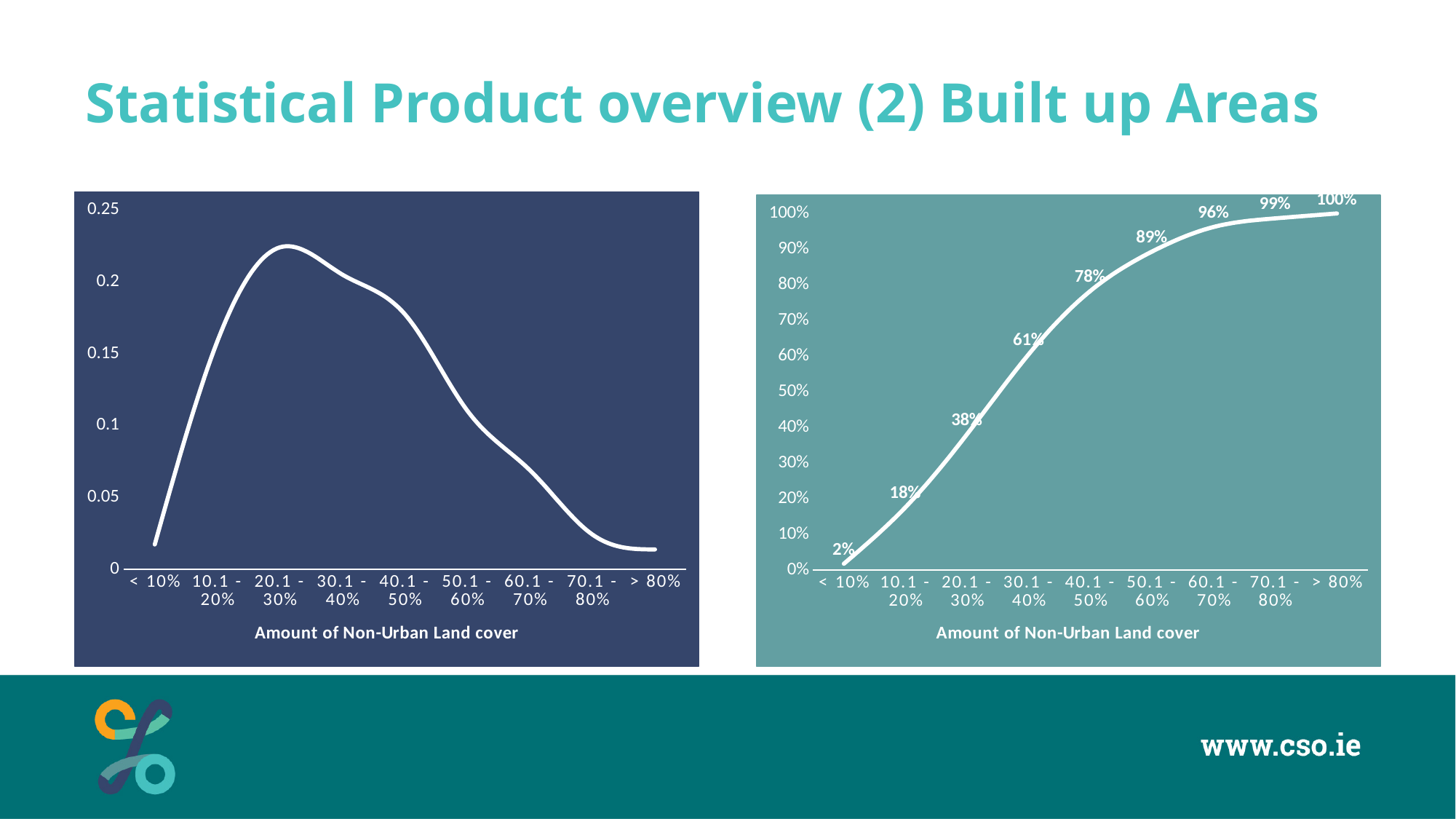
What kind of chart is the left chart? line chart On the left chart, is the value for 40.1 - 50% greater or less than 0.15? greater What is the x-axis title of the left chart? Amount of Non-Urban Land cover On the right chart, do the values rise or fall from left to right along the x axis? rise On the right chart, what is the value for the 60.1 - 70% category? 96% On the right chart, what is the difference between the values for 40.1 - 50% and 10.1 - 20%? 60% On the right chart, what is the value for the < 10% category? 2% How many categories are shown on the x axis of the right chart? 9 On the right chart, which category has the highest value? > 80% On the left chart, which category has the highest value? 20.1 - 30% On the right chart, which category has the lowest value? < 10% On the right chart, what is the value for the 30.1 - 40% category? 61%